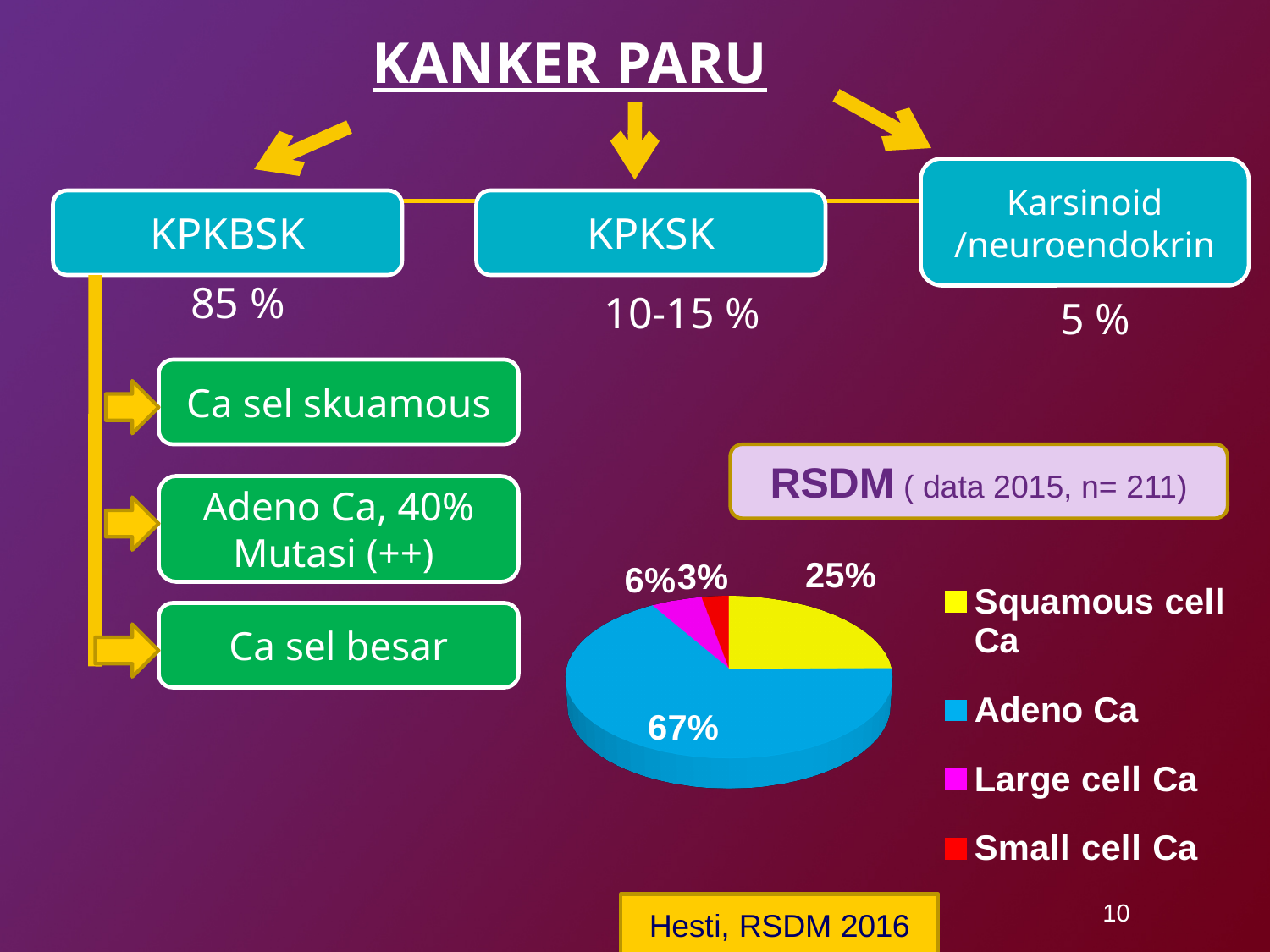
Which is larger in the pie chart, Large cell Ca or Small cell Ca? Large cell Ca What kind of chart is shown on the slide? pie chart What percentage of the pie chart is Small cell Ca? 3% What is the difference in percentage points between Adeno Ca and Squamous cell Ca in the pie chart? 42 Which category has the largest share of the pie chart? Adeno Ca What percentage of the pie chart is Large cell Ca? 6% Which category has the smallest share of the pie chart? Small cell Ca How many categories does the pie chart legend list? 4 What is the sample size (n) stated for the RSDM pie chart data? 211 What percentage of the pie chart is Squamous cell Ca? 25% What percentage of the pie chart is Adeno Ca? 67% What colour represents Adeno Ca in the pie chart? blue